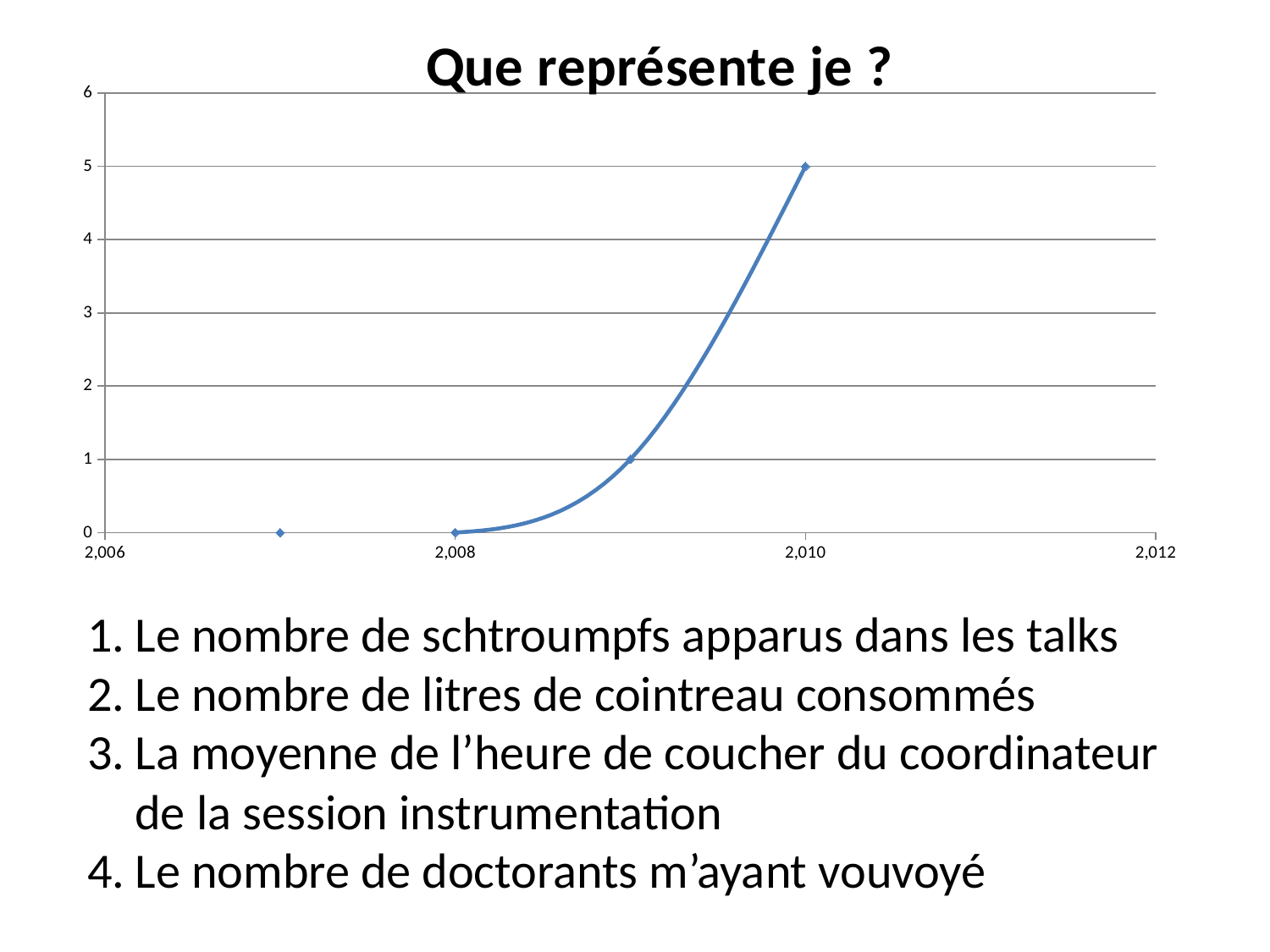
What is the value of the point at 2,010? 5 Which is larger, the value at 2,010 or the value at 2,008? 2,010 Is the value of the point at 2,010 greater or less than 4? greater What is the title of the chart? Que représente je ? At which x-axis value does the highest point occur? 2,010 What kind of chart is shown on the slide? line chart What is the value of the point at 2,008? 0 How many data points are plotted on the chart? 4 Do the values rise or fall from left to right along the x axis? rise What is the difference between the value at 2,010 and the value at 2,008? 5 What is the highest value shown on the y axis? 6 What is the value of the third point from the left? 1